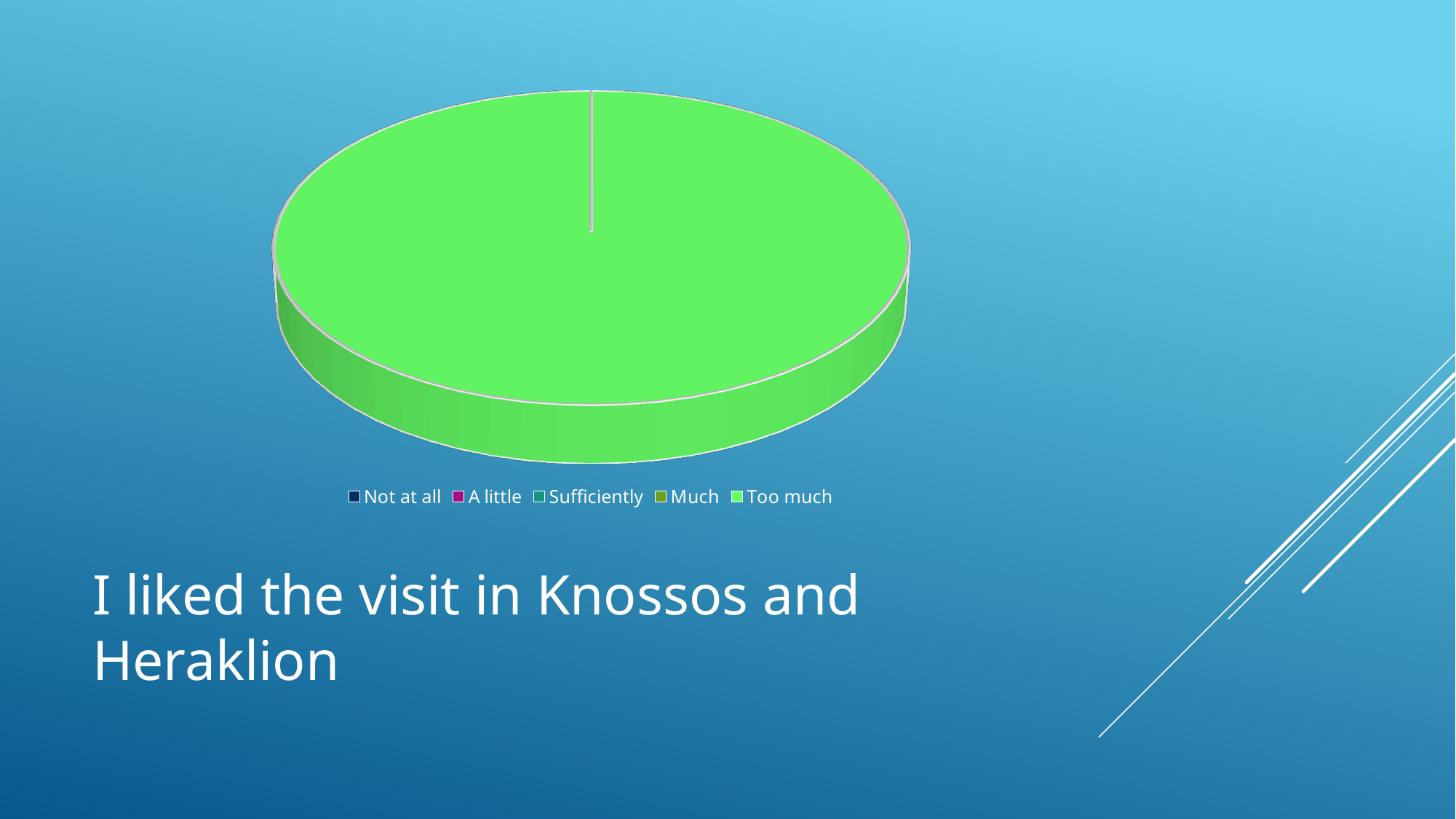
What text appears below the pie chart on the slide? I liked the visit in Knossos and Heraklion How many categories does the legend of the pie chart list? 5 What kind of chart is shown on the slide? pie chart Which has the larger share of the pie, Too much or Not at all? Too much Which category takes up the largest share of the pie chart? Too much Which has the larger share of the pie, Too much or A little? Too much Does the Too much slice fill the entire pie chart? yes